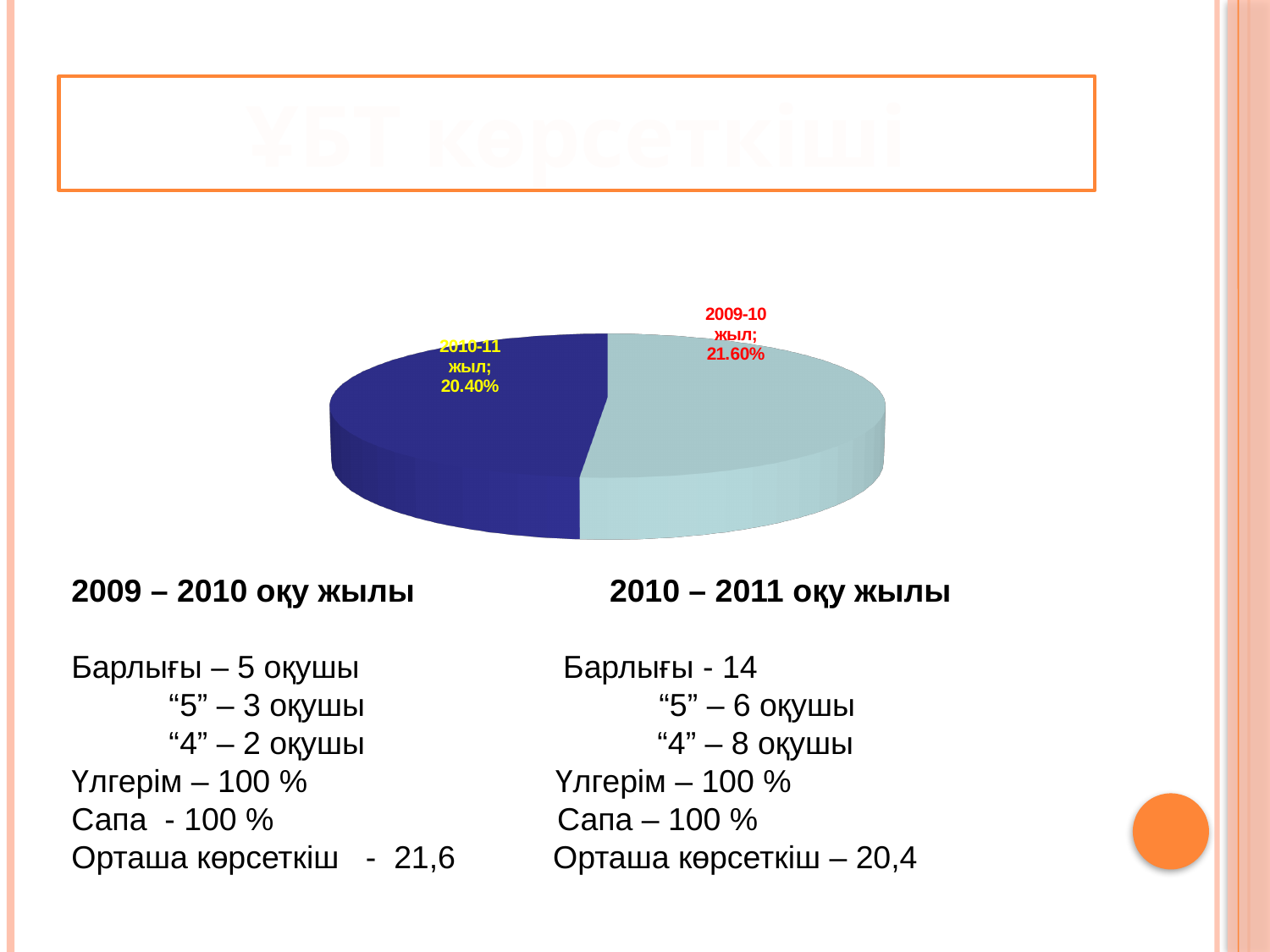
Which slice has the lowest value in the pie chart? 2010-11 жыл What value is shown for the 2009-10 жыл slice? 21.60% How many slices does the pie chart have? 2 What colour is the 2010-11 жыл slice? dark blue Which slice has the highest value in the pie chart? 2009-10 жыл What is the difference between the values for 2009-10 жыл and 2010-11 жыл? 1.20% What kind of chart is shown on the slide? pie chart Which slice has the higher value, 2009-10 жыл or 2010-11 жыл? 2009-10 жыл What colour is the 2009-10 жыл slice? light blue What value is shown for the 2010-11 жыл slice? 20.40%